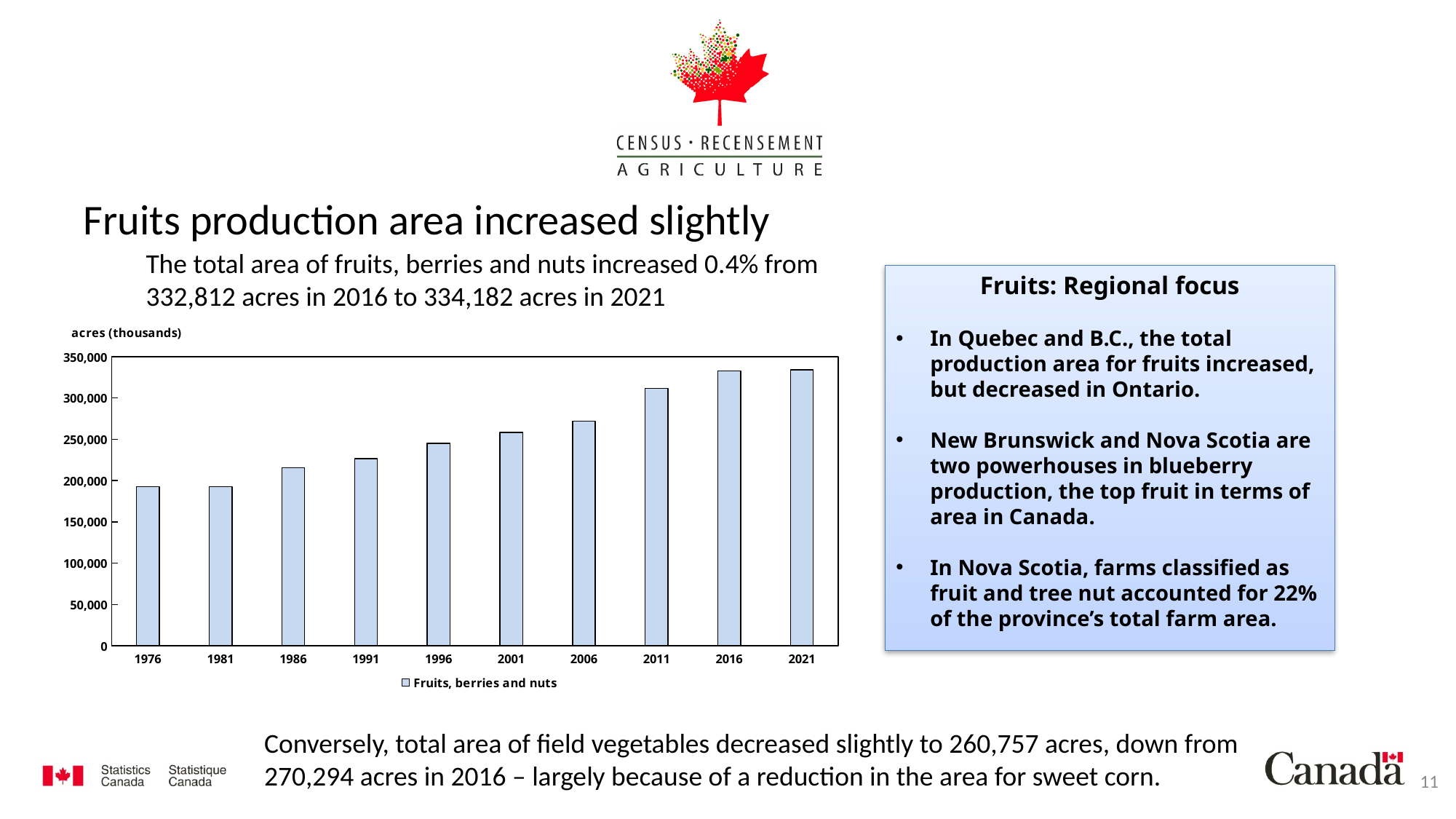
Is the value for 2006 greater or less than 250,000? greater What kind of chart is shown on the slide? bar chart What is the label on the vertical axis of the chart? acres (thousands) Do the values generally rise or fall from 1976 to 2021? rise Is the value for 1976 greater or less than 200,000? less Which year has the larger value, 2006 or 2011? 2011 How many years (bars) are plotted on the chart? 10 How many series does the chart legend list? 1 Is the value for 1986 greater or less than 200,000? greater What is the name of the series shown in the chart legend? Fruits, berries and nuts